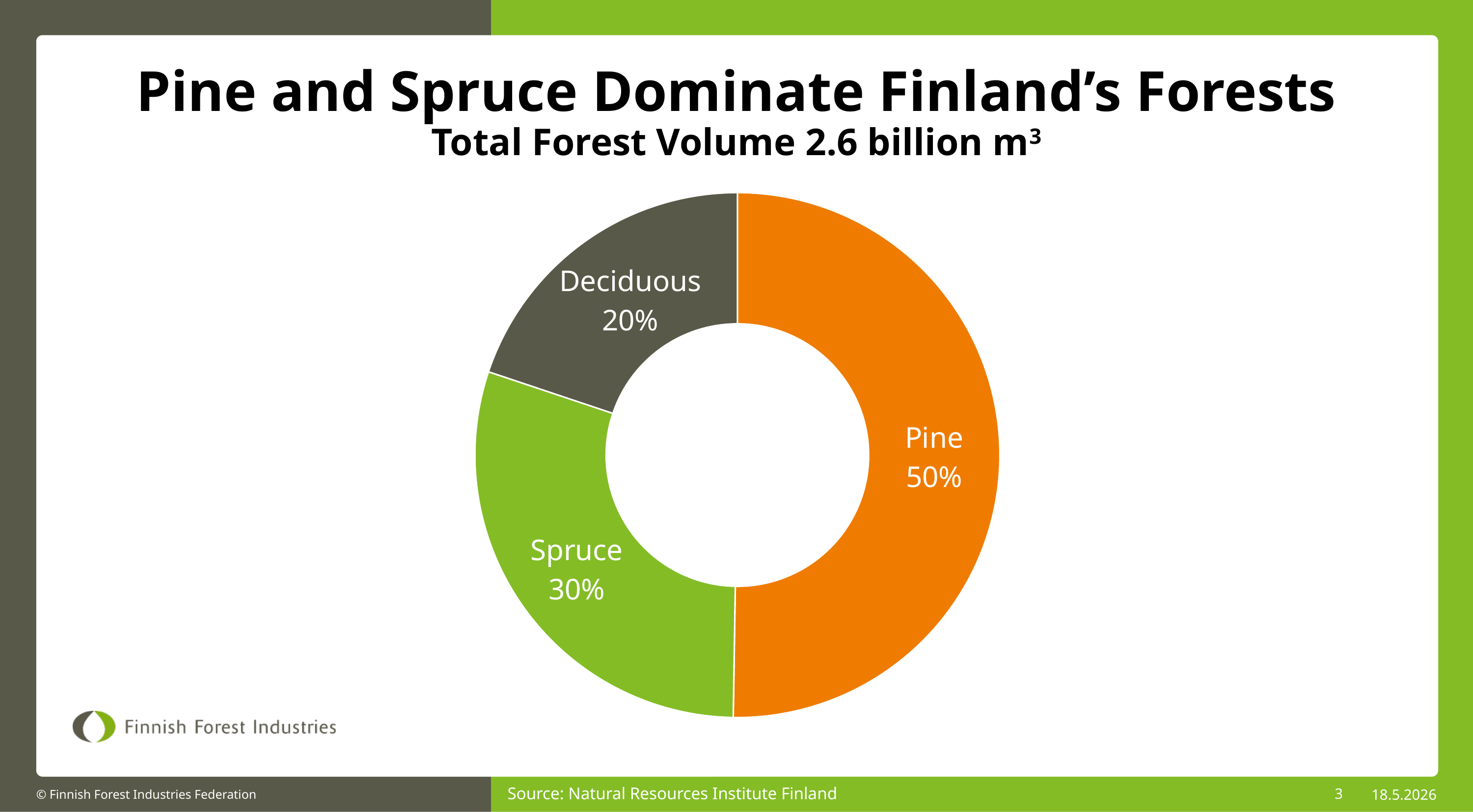
What is the combined share of Pine and Spruce? 80% What kind of chart is shown on the slide? Doughnut (pie) chart What share of Finland's forest volume is Pine? 50% How many percentage points larger is the Pine share than the Spruce share? 20 percentage points Which tree type has the smallest share of the forest volume? Deciduous How many tree categories are shown in the chart? 3 What share of Finland's forest volume is Spruce? 30% How many percentage points larger is the Spruce share than the Deciduous share? 10 percentage points Which has a larger share of forest volume, Spruce or Deciduous? Spruce What colour is the Pine segment of the chart? Orange What share of Finland's forest volume is Deciduous? 20% Which tree type has the largest share of the forest volume? Pine